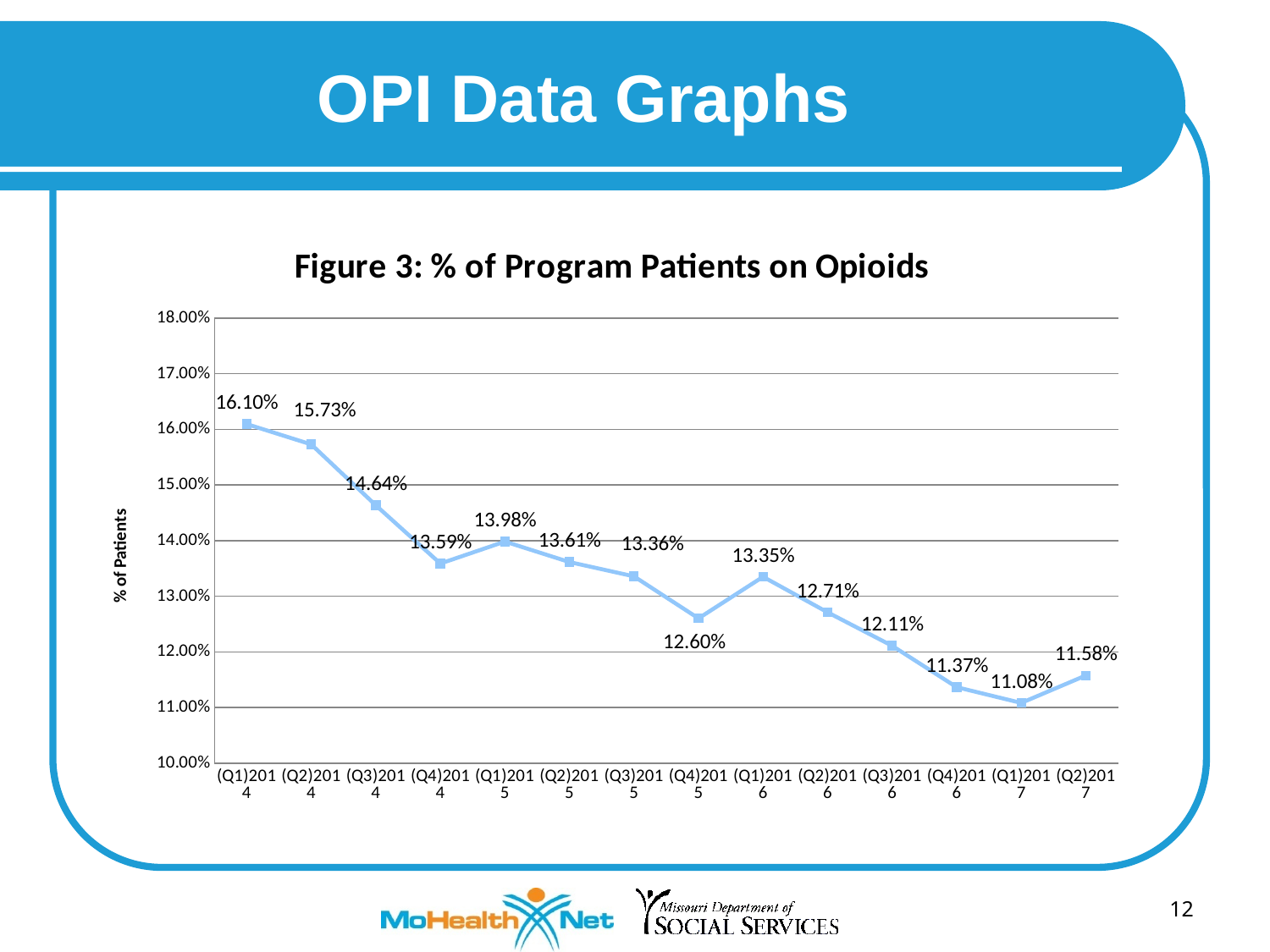
What is the value for (Q4)2015 in Figure 3? 12.60% Is the value for (Q3)2014 greater or less than 14.00%? greater Which quarter has the lowest % of program patients on opioids? (Q1)2017 What is the value for (Q1)2014 in Figure 3? 16.10% What is the difference between the values for (Q1)2014 and (Q2)2014? 0.37% Which quarter has the highest % of program patients on opioids? (Q1)2014 Which is larger, the value for (Q1)2015 or the value for (Q4)2014? (Q1)2015 What is the value for (Q2)2017 in Figure 3? 11.58% Overall, do the values in Figure 3 rise or fall from (Q1)2014 to (Q2)2017? fall What kind of chart is Figure 3? line chart How many quarters are plotted in Figure 3? 14 What is the difference between the values for (Q1)2017 and (Q2)2017? 0.50%